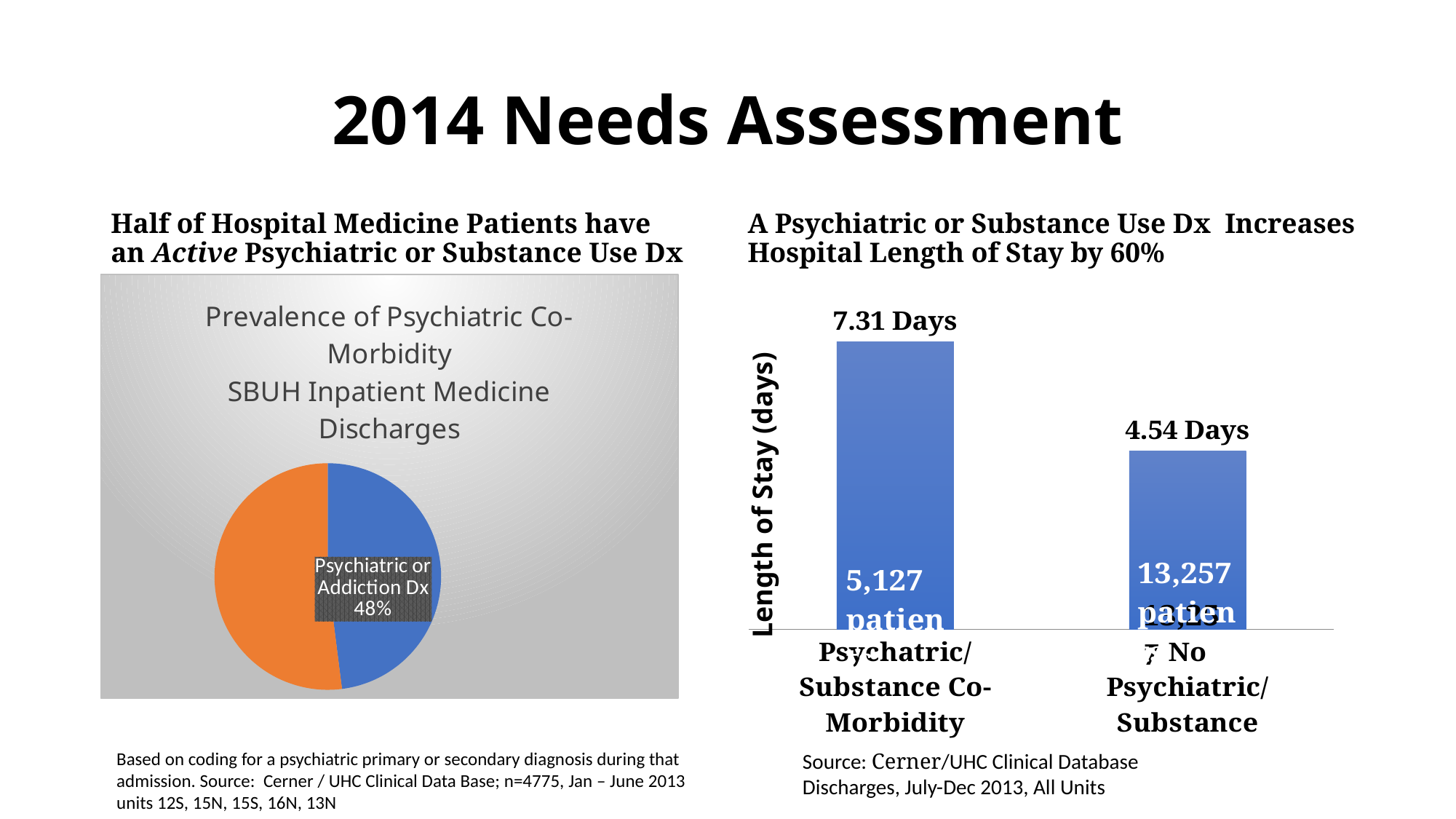
On the left chart, what is the title of the pie chart? Prevalence of Psychiatric Co-Morbidity SBUH Inpatient Medicine Discharges On the right chart, which category has the shorter length of stay? No Psychiatric/Substance On the right chart, how many bars are plotted? 2 On the right chart, how many patients are in the Psychiatric/Substance Co-Morbidity group? 5,127 On the right chart, what is the length of stay for Psychiatric/Substance Co-Morbidity? 7.31 Days On the right chart, what is the difference in length of stay between Psychiatric/Substance Co-Morbidity and No Psychiatric/Substance? 2.77 Days On the left chart, what kind of chart is shown? pie chart On the left pie chart, what share of discharges had a Psychiatric or Addiction Dx? 48% On the right chart, what kind of chart is shown? bar chart On the right chart, which category has the longer length of stay? Psychiatric/Substance Co-Morbidity On the right chart, what is the label of the vertical axis? Length of Stay (days) On the right chart, what is the length of stay for No Psychiatric/Substance? 4.54 Days